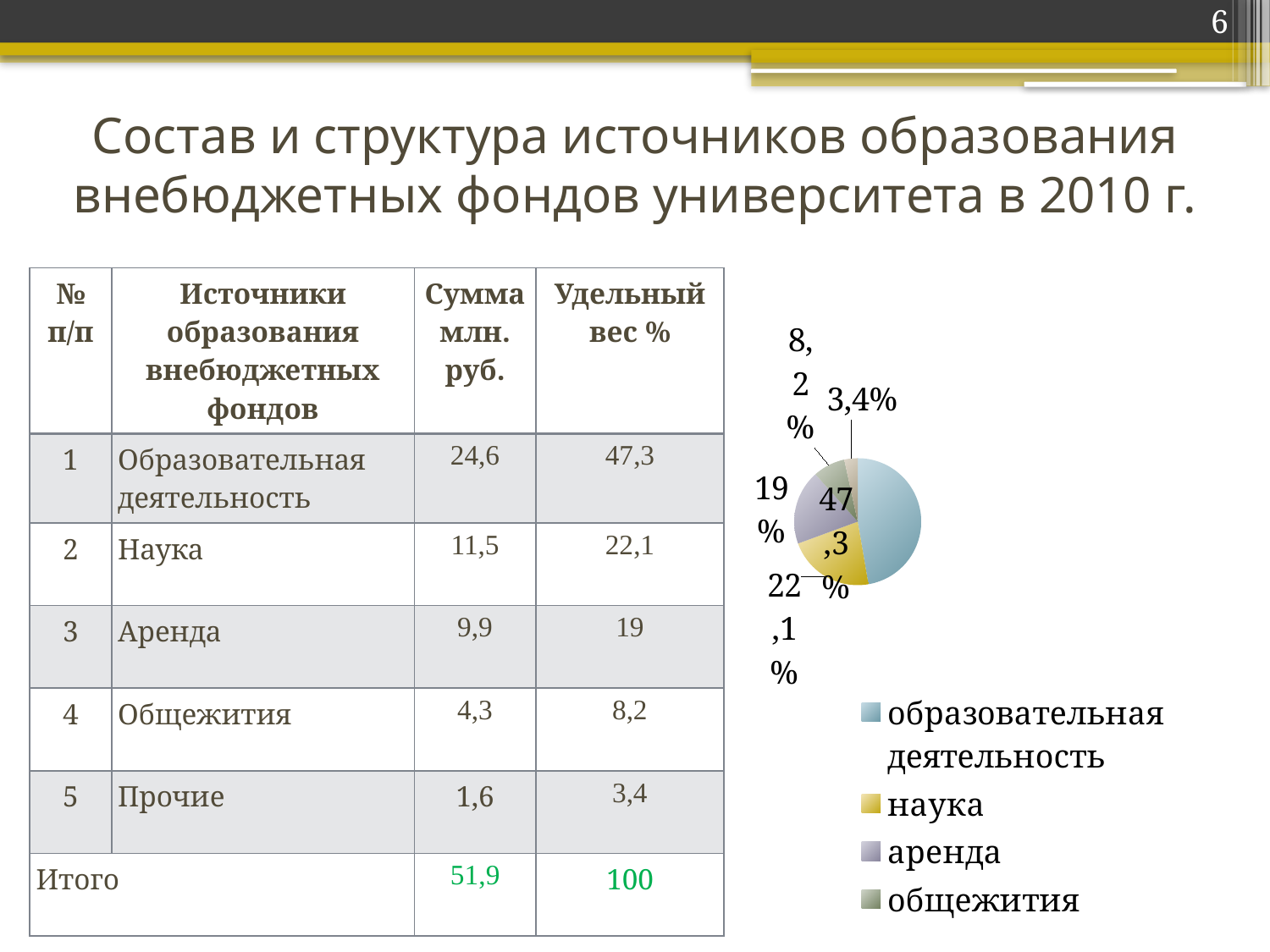
In the pie chart, what share does наука have? 22,1% In the pie chart, which is larger: наука or аренда? наука How many slices does the pie chart have? 5 What is the difference between the shares of образовательная деятельность and наука in the pie chart? 25,2% Which category has the largest slice in the pie chart? образовательная деятельность In the pie chart, what share does общежития have? 8,2% In the pie chart, what share does образовательная деятельность have? 47,3% What colour is the slice for наука in the pie chart? yellow How many entries are listed in the pie chart's legend? 4 What kind of chart is shown on the slide? pie chart In the pie chart, what share does аренда have? 19% Which slice of the pie chart is the smallest? 3,4%